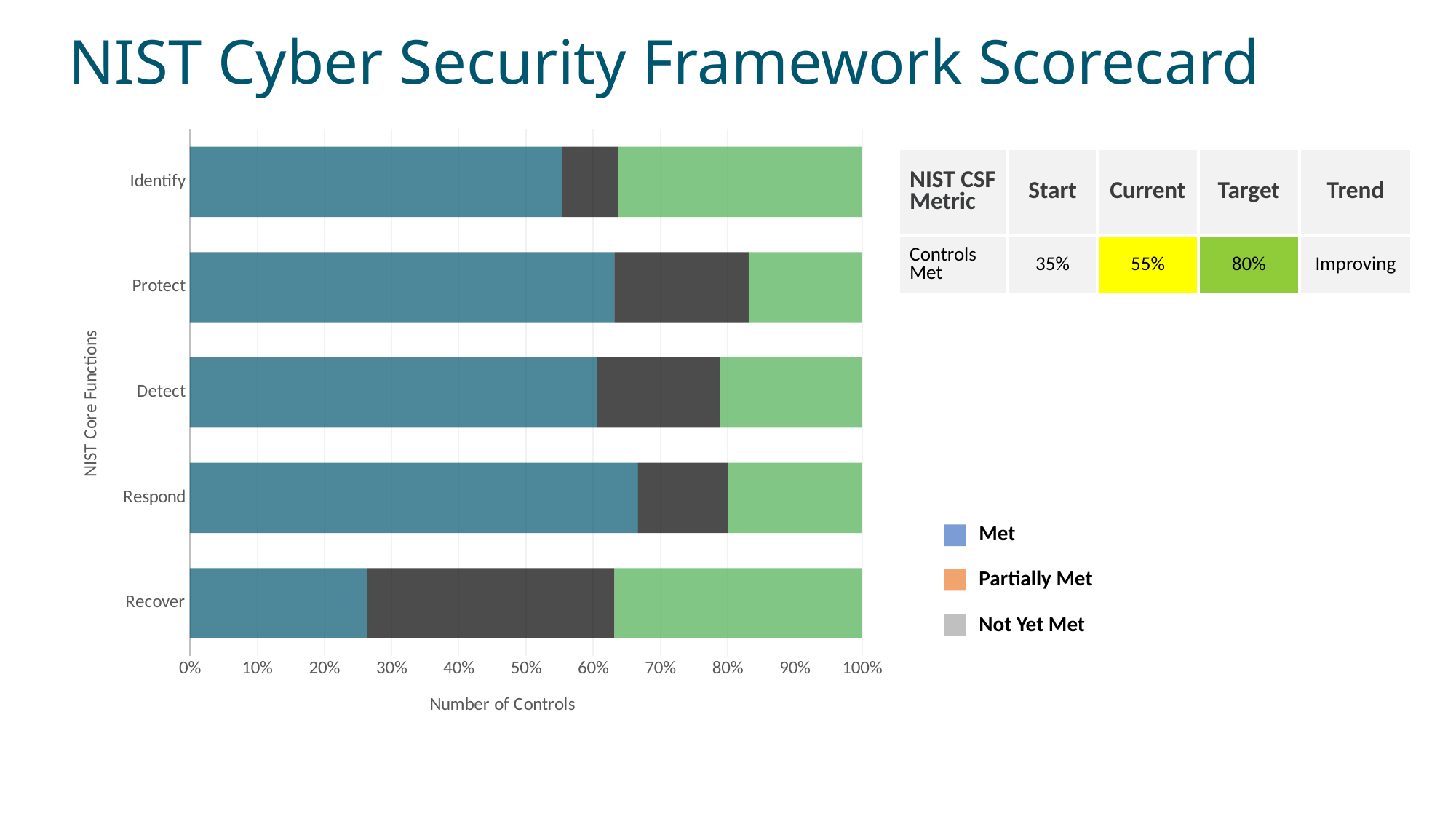
Which NIST Core Function has the largest Partially Met share? Recover Is the Met value for Respond greater or less than 60%? greater Is the Met value for Recover greater or less than 30%? less Is the Met value for Identify greater or less than 50%? greater What is the title of the x axis of the chart? Number of Controls How many series does the chart legend list? 3 Which NIST Core Function has the lowest Met share? Recover What kind of chart is shown on the slide? Stacked bar chart Which NIST Core Function has the smallest Partially Met share? Identify Which has a larger Met share, Identify or Recover? Identify What are the three legend entries of the chart? Met, Partially Met, Not Yet Met How many NIST Core Functions are plotted on the chart? 5